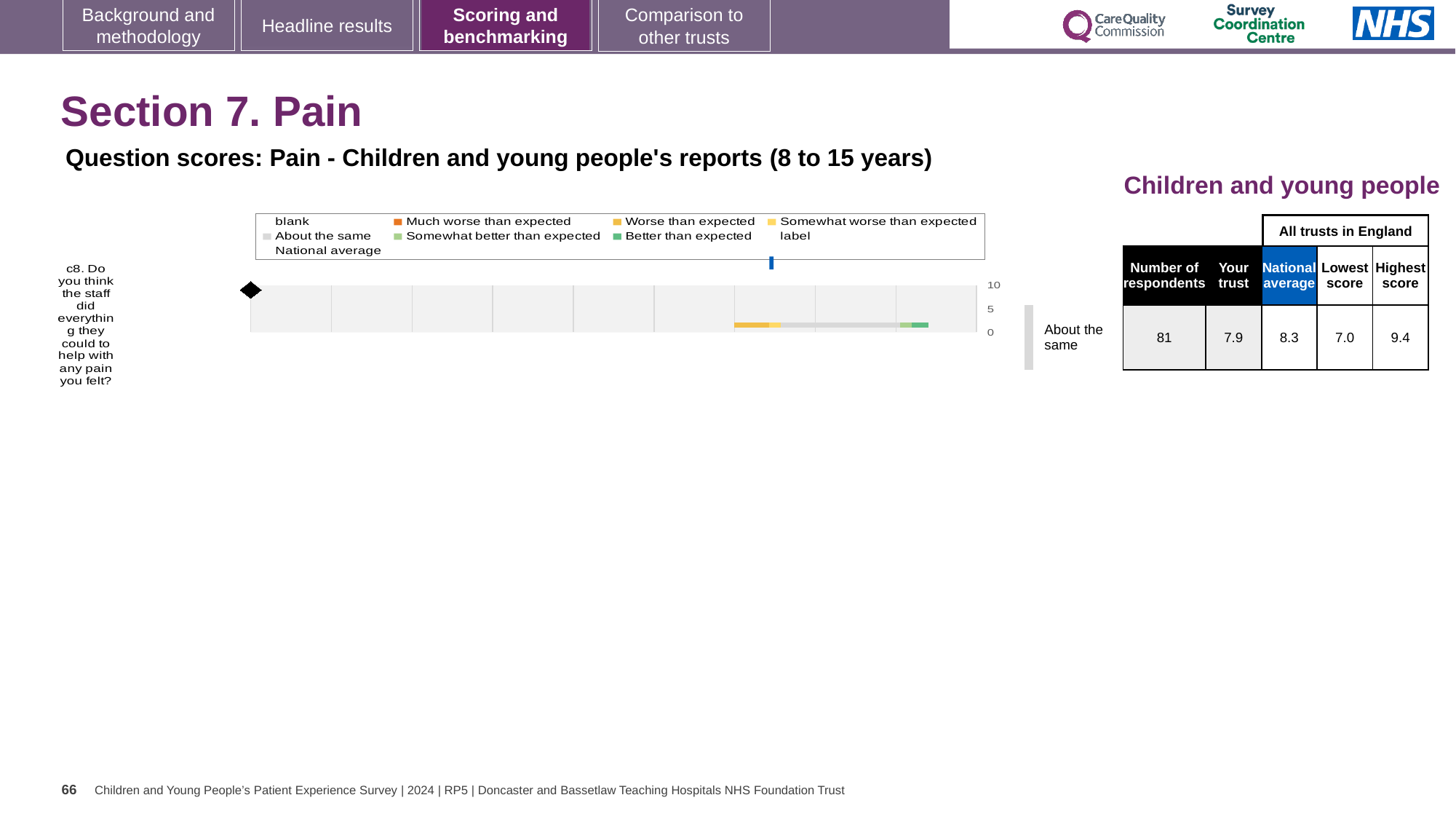
In the table beside the chart, what is the number of respondents for question c8? 81 What benchmark category is shown next to the chart for question c8? About the same What is the difference between the highest score (9.4) and the lowest score (7.0) for question c8? 2.4 In the table beside the chart, what is the highest score among all trusts in England for question c8? 9.4 In the table beside the chart, what is the 'Your trust' score for question c8? 7.9 How many survey questions are plotted in the chart? 1 Which is larger for question c8, the 'Your trust' score or the National average? National average What is the highest value shown on the chart's axis? 10 In the table beside the chart, what is the National average score for question c8? 8.3 In the table beside the chart, what is the lowest score among all trusts in England for question c8? 7.0 Which question is plotted in the chart? c8. Do you think the staff did everything they could to help with any pain you felt? What kind of chart is shown on the slide? bar chart